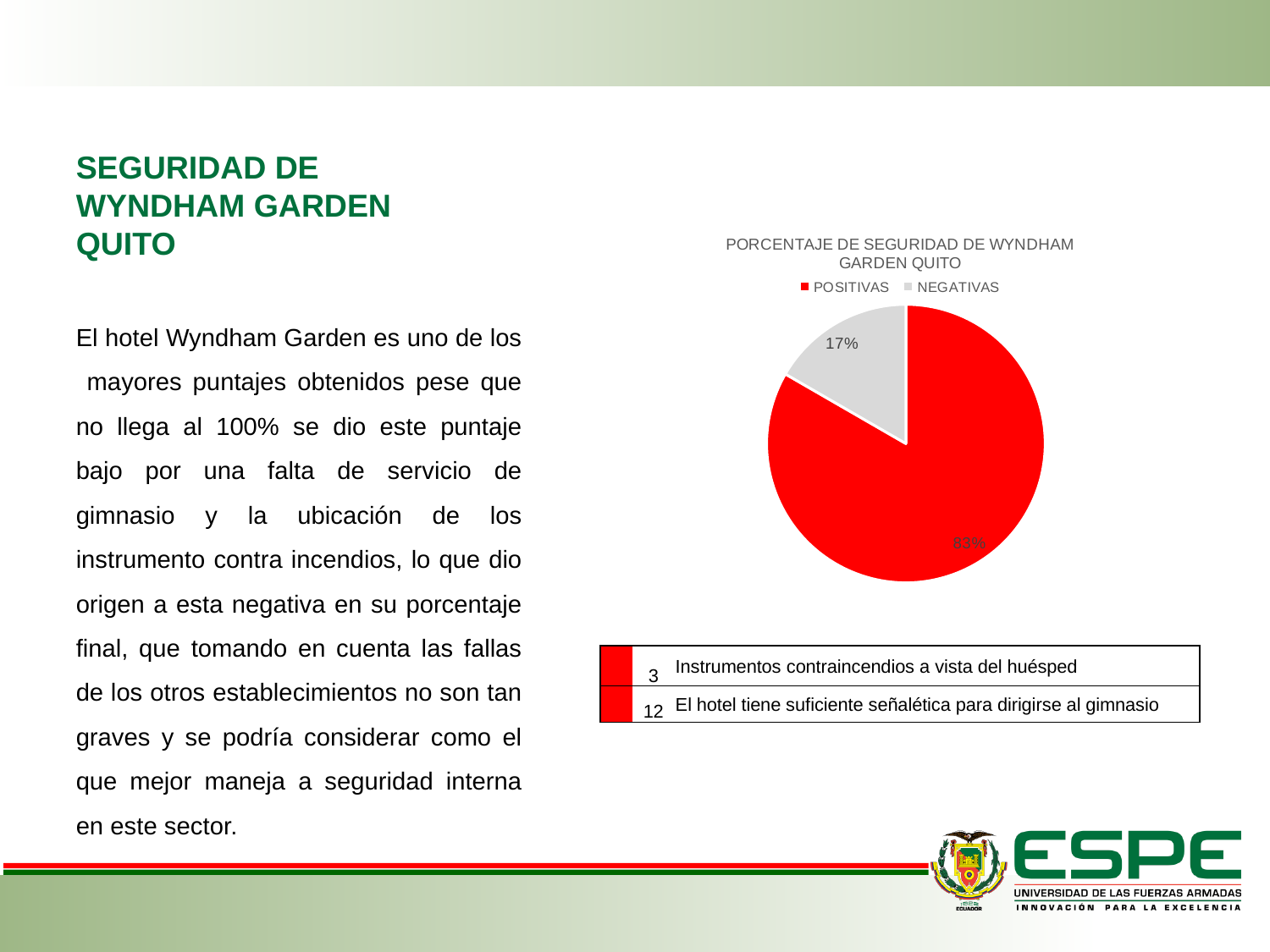
What is the difference in percentage points between the POSITIVAS and NEGATIVAS slices? 66 What percentage does the POSITIVAS slice show? 83% How many slices does the pie chart have? 2 Which slice is the smallest in the pie chart? NEGATIVAS What colour is the POSITIVAS slice? red What percentage does the NEGATIVAS slice show? 17% What is the title of the chart? PORCENTAJE DE SEGURIDAD DE WYNDHAM GARDEN QUITO How many entries does the legend list? 2 What share of the pie does the NEGATIVAS slice represent? 17% Which is larger, the POSITIVAS slice or the NEGATIVAS slice? POSITIVAS What kind of chart is shown on the slide? pie chart Which slice is the largest in the pie chart? POSITIVAS